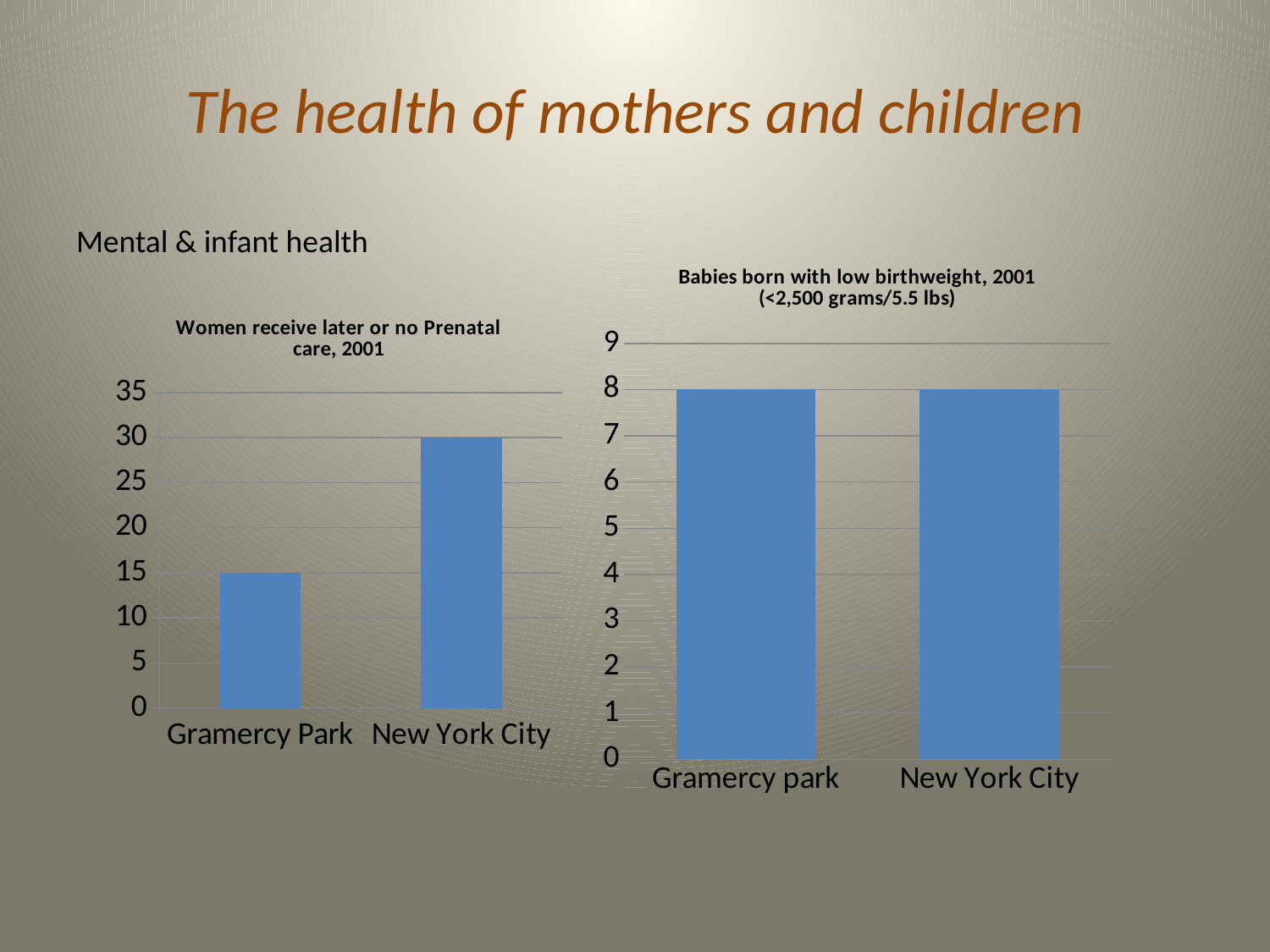
In the chart titled 'Women receive later or no Prenatal care, 2001', which category has the lowest value? Gramercy Park In the chart titled 'Women receive later or no Prenatal care, 2001', what is the value for Gramercy Park? 15 In the chart titled 'Women receive later or no Prenatal care, 2001', what is the value for New York City? 30 In the chart titled 'Babies born with low birthweight, 2001', what is the value for New York City? 8 In the chart titled 'Babies born with low birthweight, 2001', what is the value for Gramercy park? 8 What is the title of the chart on the left of the slide? Women receive later or no Prenatal care, 2001 In the chart titled 'Women receive later or no Prenatal care, 2001', is the value for Gramercy Park greater or less than 20? less In the chart titled 'Women receive later or no Prenatal care, 2001', which category has the highest value? New York City In the chart titled 'Women receive later or no Prenatal care, 2001', what is the difference between the values for New York City and Gramercy Park? 15 In the chart titled 'Babies born with low birthweight, 2001', what is the difference between the values for Gramercy park and New York City? 0 What type of chart is the chart on the right of the slide? Bar chart In the chart titled 'Babies born with low birthweight, 2001', how many categories are shown on the x axis? 2